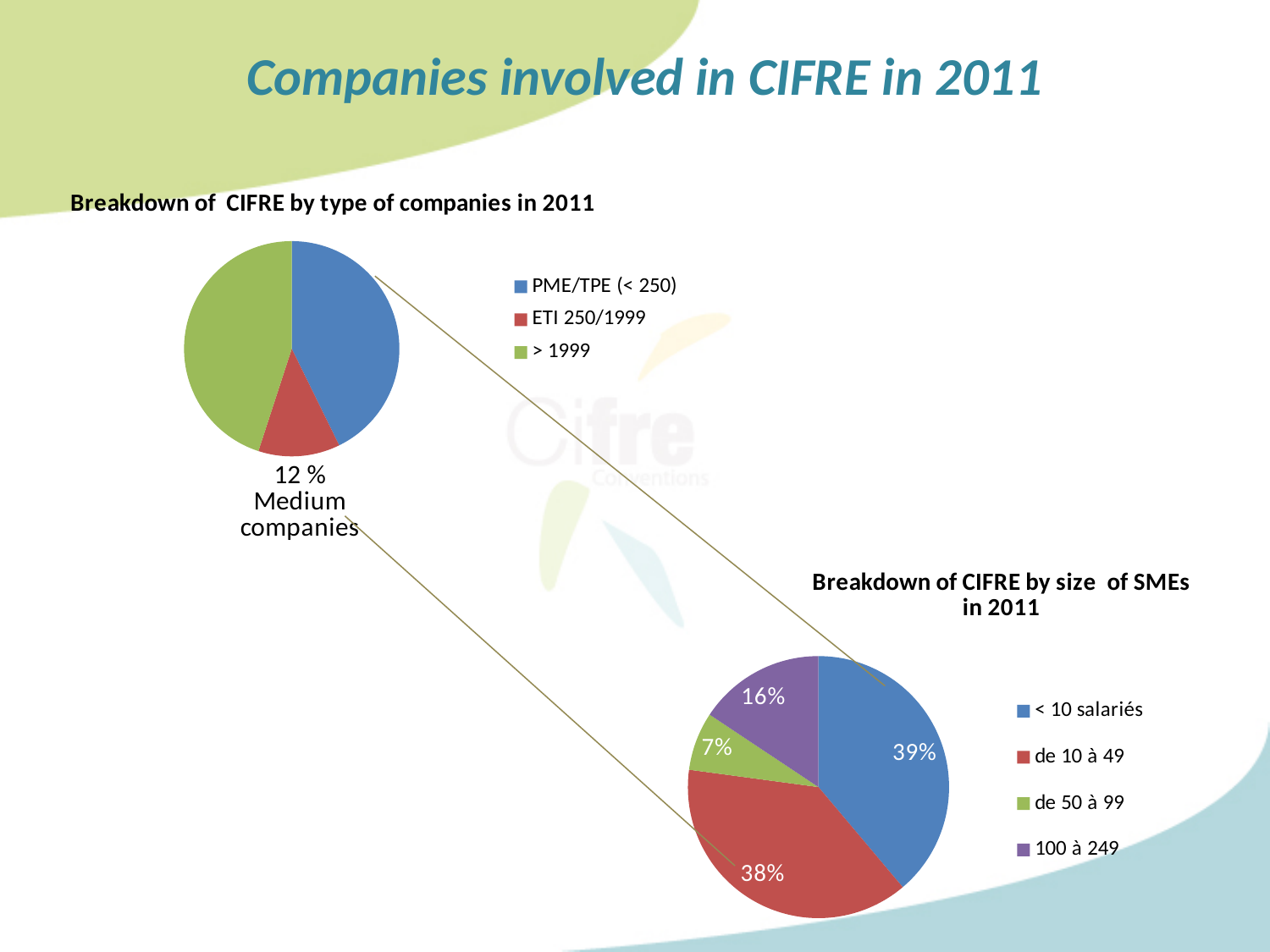
What kind of chart is used for 'Breakdown of CIFRE by size of SMEs in 2011'? Pie chart In the 'Breakdown of CIFRE by size of SMEs in 2011' chart, which category has the largest share? < 10 salariés How many categories does the legend of the 'Breakdown of CIFRE by type of companies in 2011' chart list? 3 How many categories does the legend of the 'Breakdown of CIFRE by size of SMEs in 2011' chart list? 4 In the 'Breakdown of CIFRE by type of companies in 2011' chart, what percentage is labelled for medium companies? 12 % In the 'Breakdown of CIFRE by size of SMEs in 2011' chart, what share is shown for 'de 50 à 99'? 7% In the 'Breakdown of CIFRE by type of companies in 2011' chart, which category has the smallest slice? ETI 250/1999 In the 'Breakdown of CIFRE by size of SMEs in 2011' chart, what is the difference between the shares for '100 à 249' and 'de 50 à 99'? 9% In the 'Breakdown of CIFRE by size of SMEs in 2011' chart, what share is shown for 'de 10 à 49'? 38% In the 'Breakdown of CIFRE by size of SMEs in 2011' chart, which category has the smallest share? de 50 à 99 In the 'Breakdown of CIFRE by size of SMEs in 2011' chart, what share is shown for '< 10 salariés'? 39% In the 'Breakdown of CIFRE by size of SMEs in 2011' chart, what share is shown for '100 à 249'? 16%